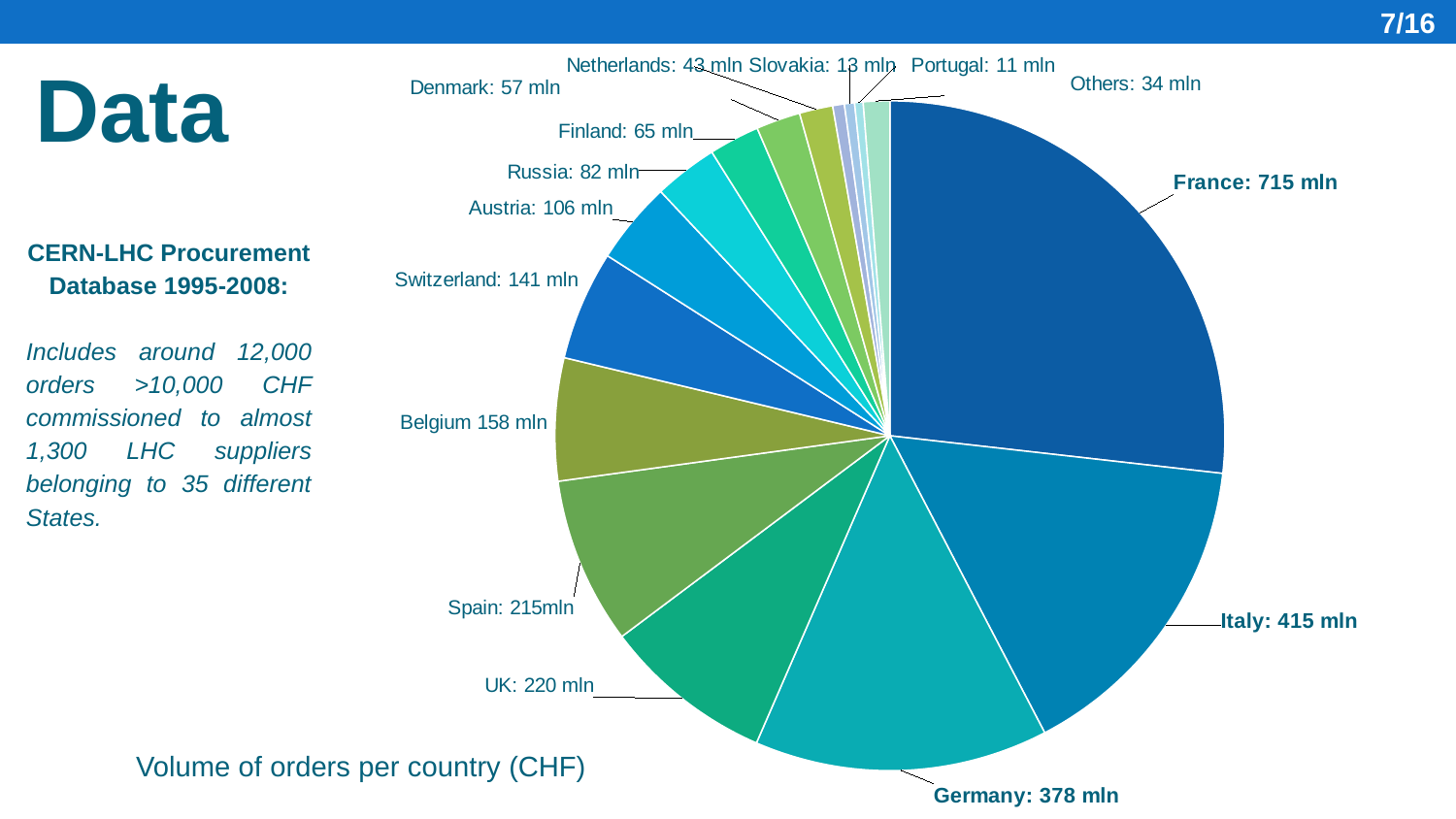
What kind of chart is shown on the slide? Pie chart How many slices does the pie chart have? 16 What is the title of the chart? Volume of orders per country (CHF) Which country has the largest volume of orders? France Which named country has the smallest volume of orders? Portugal What is the difference between the volume of orders for UK and Spain? 5 mln What is the volume of orders for Germany? 378 mln What is the volume of orders for Slovakia? 13 mln What is the volume of orders for France? 715 mln Which has a larger volume of orders, Austria or Russia? Austria What is the volume of orders for Switzerland? 141 mln What is the difference between the volume of orders for France and Italy? 300 mln